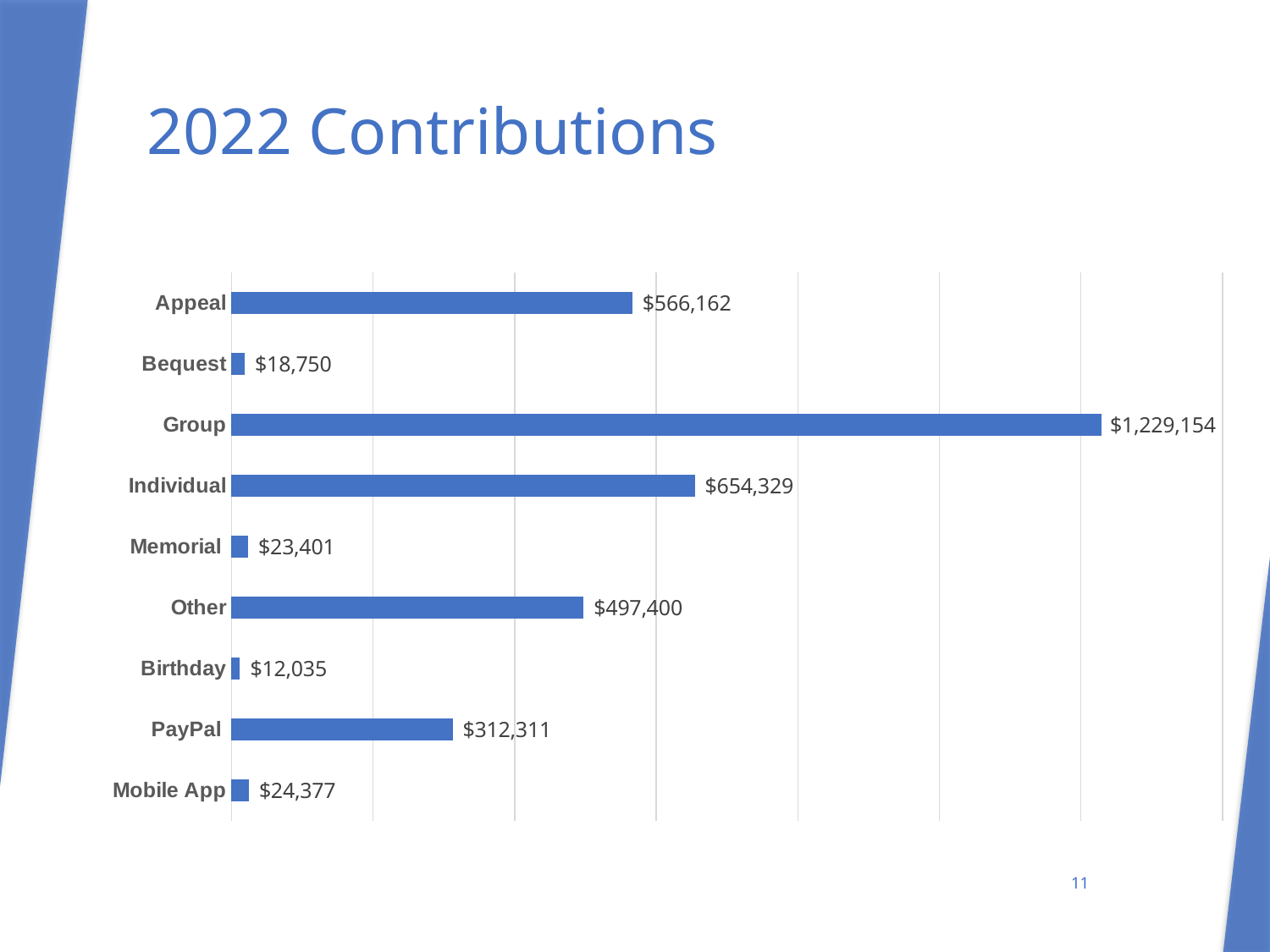
Which is larger, Other or PayPal? Other What is the value for PayPal? $312,311 Which category has the lowest contribution? Birthday What is the value for Group? $1,229,154 What is the value for Memorial? $23,401 What kind of chart is shown on the slide? Bar chart What is the difference between the Individual and Appeal values? $88,167 What is the title of the slide? 2022 Contributions Which category has the highest contribution? Group Which is larger, Bequest or Mobile App? Mobile App What is the difference between the Group and Individual values? $574,825 How many categories are shown in the chart? 9